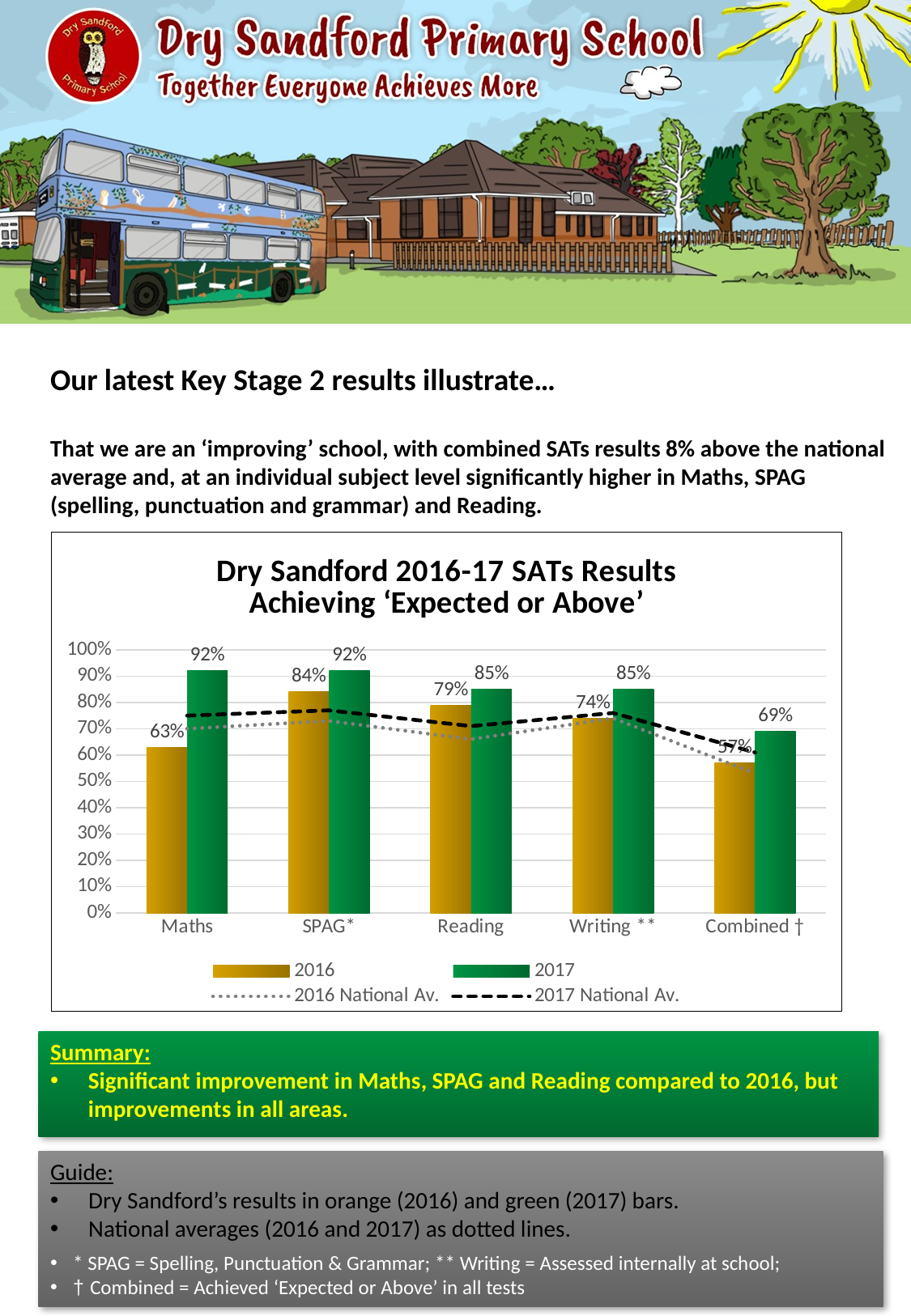
Is the 2017 National Av. value for Maths greater or less than 70%? greater Which category had the lowest 2017 result? Combined How many series does the legend list? 4 What was the 2016 result for SPAG? 84% How many categories are shown on the x axis? 5 Which subject had the highest 2016 result? SPAG By how many percentage points did the Maths result rise from 2016 to 2017? 29% Which was higher in 2016, Reading or Writing? Reading What was Dry Sandford's 2017 result for Maths? 92% What was the 2017 result for Reading? 85% What was the 2016 result for Writing? 74% What is the title of the chart? Dry Sandford 2016-17 SATs Results Achieving 'Expected or Above'